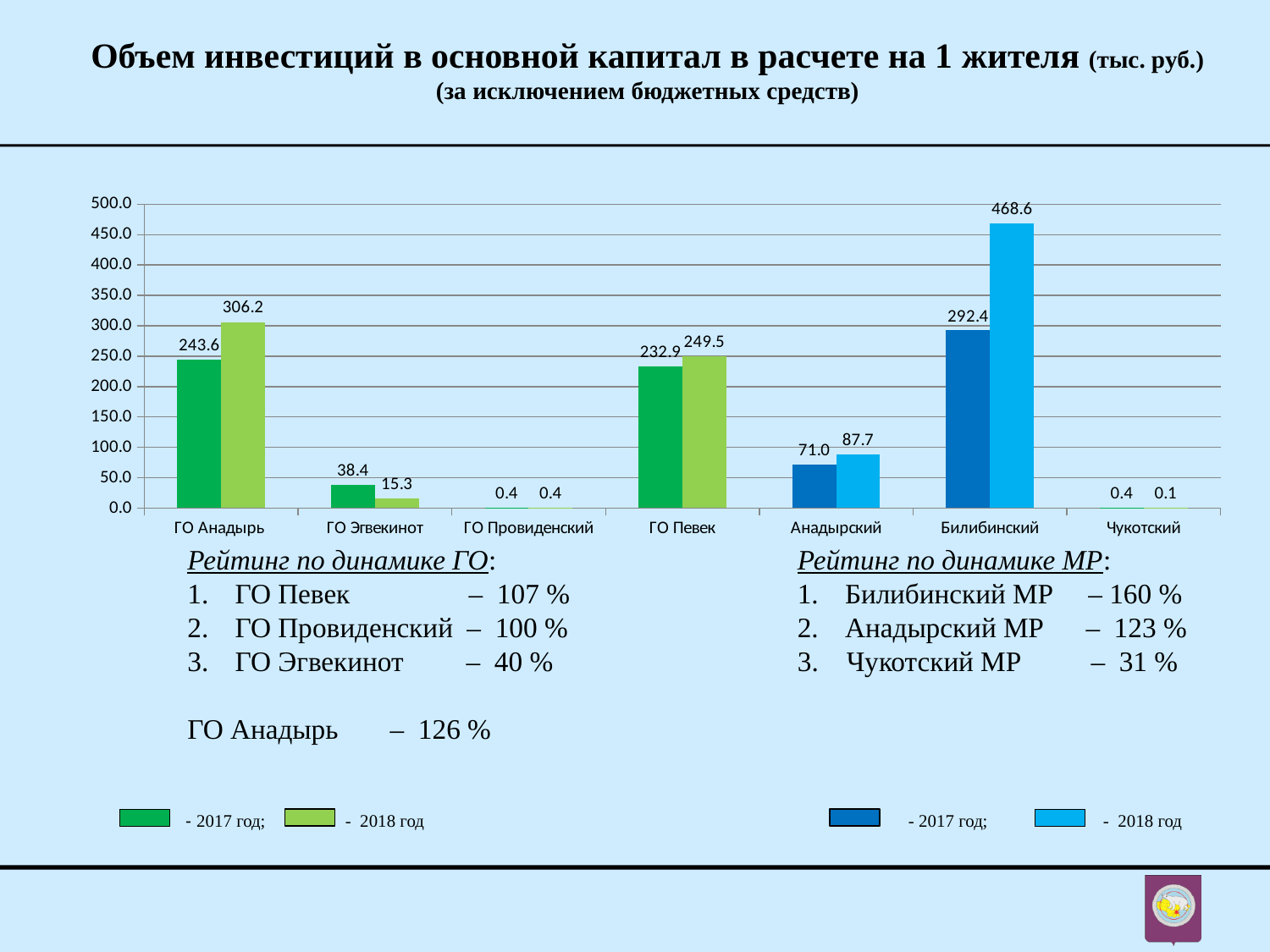
What kind of chart is shown on the slide? Bar chart What is the difference between the 2018 and 2017 values for Билибинский? 176.2 What is the 2017 value for Анадырский? 71.0 What is the 2017 value for ГО Анадырь? 243.6 Which two years are compared in the chart legend? 2017 and 2018 Which is larger for ГО Эгвекинот, the 2017 value or the 2018 value? 2017 What is the difference between the 2018 and 2017 values for ГО Анадырь? 62.6 What is the 2018 value for Билибинский? 468.6 Which category has the lowest 2018 value? Чукотский What is the 2018 value for ГО Эгвекинот? 15.3 How many categories are shown on the x axis? 7 Which category has the highest 2018 value? Билибинский